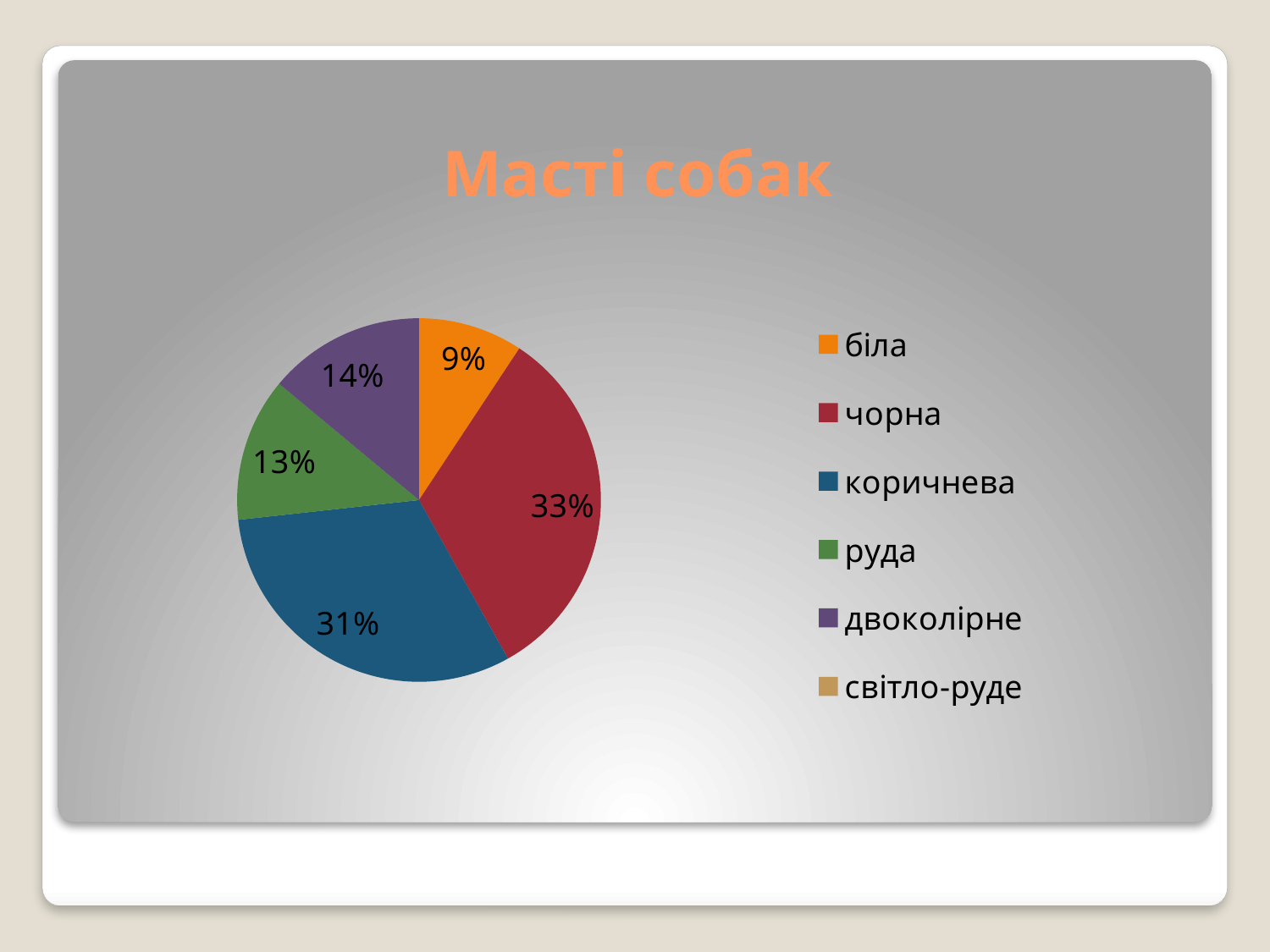
Which slice has the smallest percentage label on the pie? біла What percentage of the pie is labelled for коричнева? 31% What percentage of the pie is labelled for біла? 9% Which category has the largest share of the pie? чорна How many entries does the legend list? 6 What is the difference in percentage points between чорна and коричнева? 2% What is the title of the chart? Масті собак What percentage of the pie is labelled for двоколірне? 14% Which has a larger share, двоколірне or руда? двоколірне What percentage of the pie is labelled for руда? 13% What percentage of the pie is labelled for чорна? 33% What type of chart is shown on the slide? pie chart